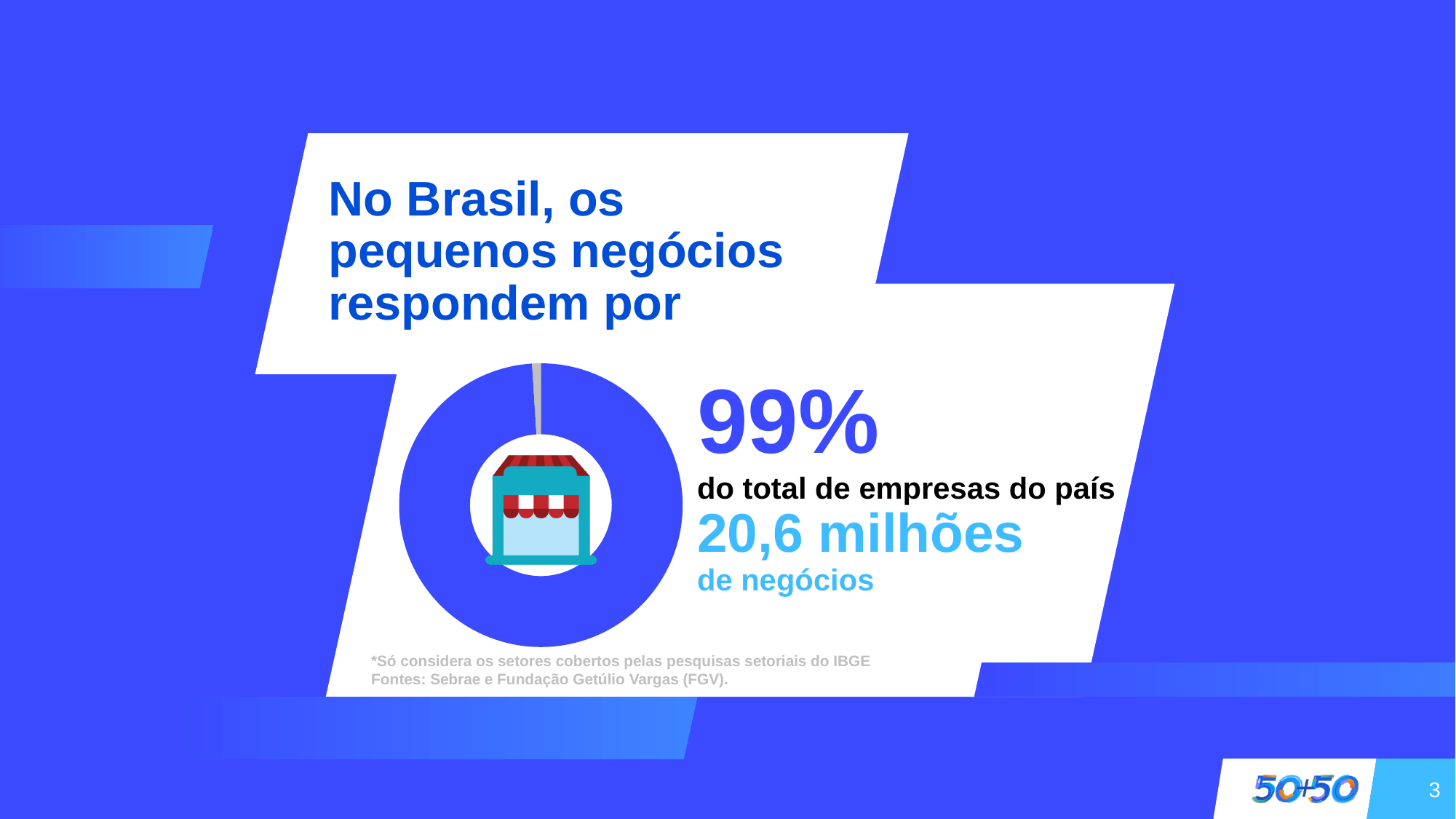
What sources are cited for the chart data? Sebrae e Fundação Getúlio Vargas (FGV) How many small businesses does the slide say there are in Brazil? 20,6 milhões What icon is shown in the centre of the donut chart? A small shop/store How many slices does the donut chart have? 2 Is the share shown for small businesses greater or less than 50%? greater What kind of chart is shown on the slide? Pie (donut) chart What share of the total number of companies in Brazil do small businesses account for, according to the chart? 99% What label accompanies the 99% figure next to the chart? do total de empresas do país Which slice of the donut chart is larger, the blue one or the thin grey one? the blue one